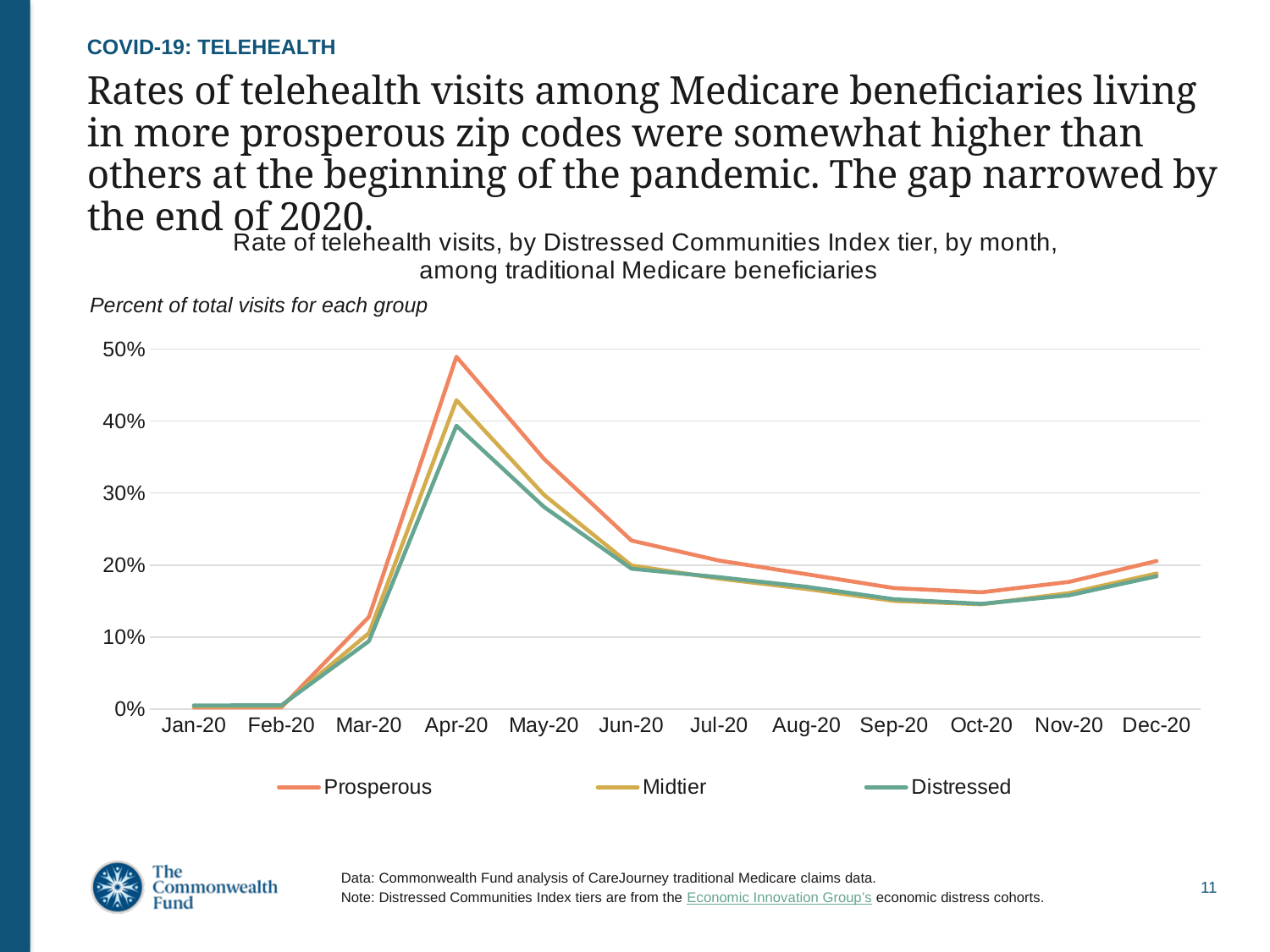
Is the value for Prosperous in Mar-20 greater or less than 20%? less Which series has the higher value in Apr-20, Prosperous or Distressed? Prosperous How many months are plotted along the x axis? 12 What kind of chart is shown on the slide? line chart How many series does the legend list? 3 Is the value for Prosperous in Apr-20 greater or less than 40%? greater Which series is drawn in orange in the legend? Prosperous What unit does the y axis of the chart measure, according to the label above it? Percent of total visits for each group In which month does the Prosperous series reach its highest value? Apr-20 In which month does the Distressed series reach its highest value? Apr-20 Do the values for the Prosperous series rise or fall from Apr-20 to Oct-20? fall Is the value for Distressed in Apr-20 greater or less than 30%? greater